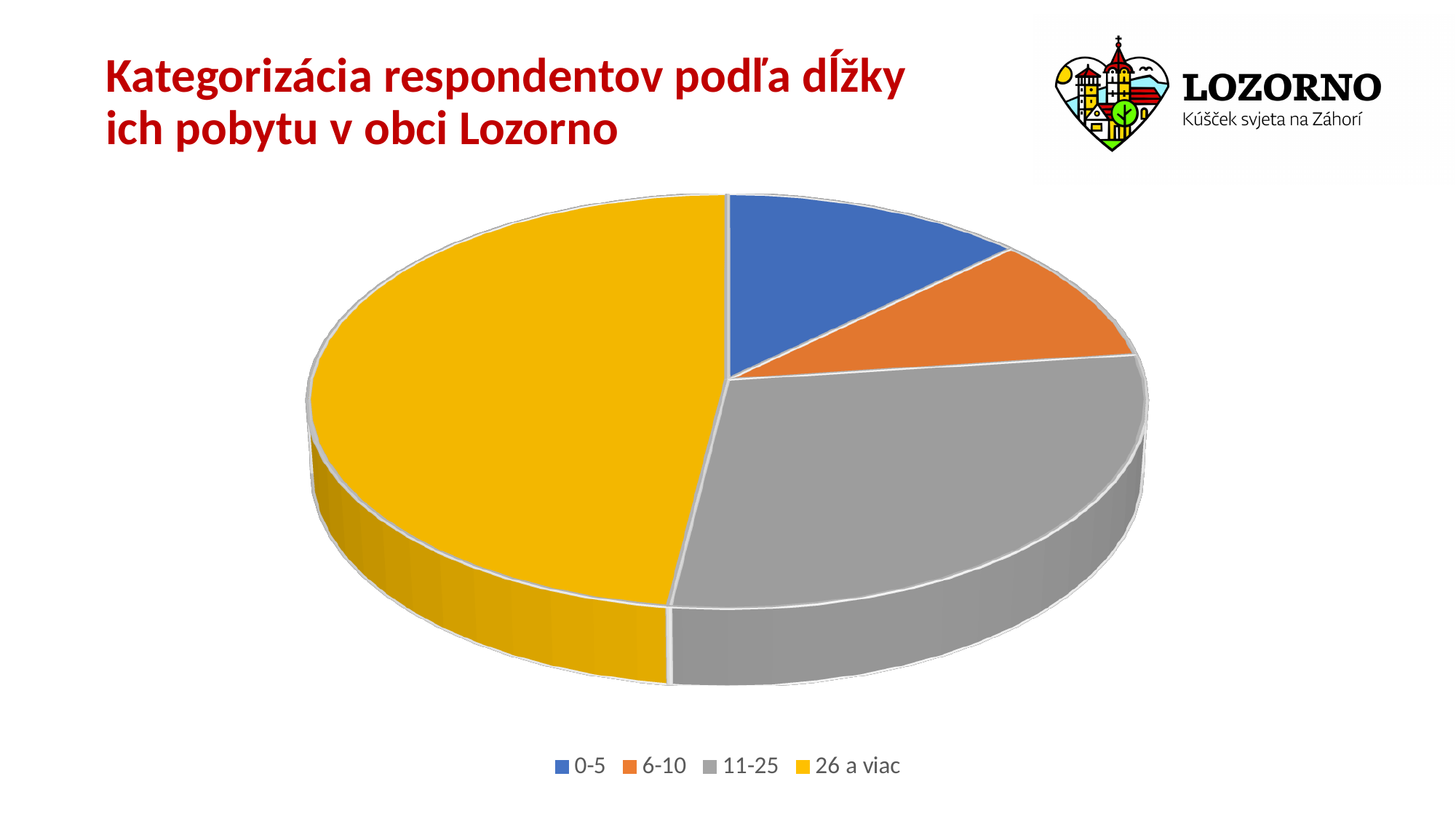
Which slice is larger, 26 a viac or 11-25? 26 a viac What kind of chart is shown on the slide? pie chart Which slice is larger, 26 a viac or 0-5? 26 a viac Which colour represents the category 11-25 in the pie chart? grey How many entries does the legend of the pie chart list? 4 Which slice is larger, 11-25 or 6-10? 11-25 How many categories does the pie chart have? 4 What is the title of the slide containing the pie chart? Kategorizácia respondentov podľa dĺžky ich pobytu v obci Lozorno Which category has the largest slice of the pie chart? 26 a viac